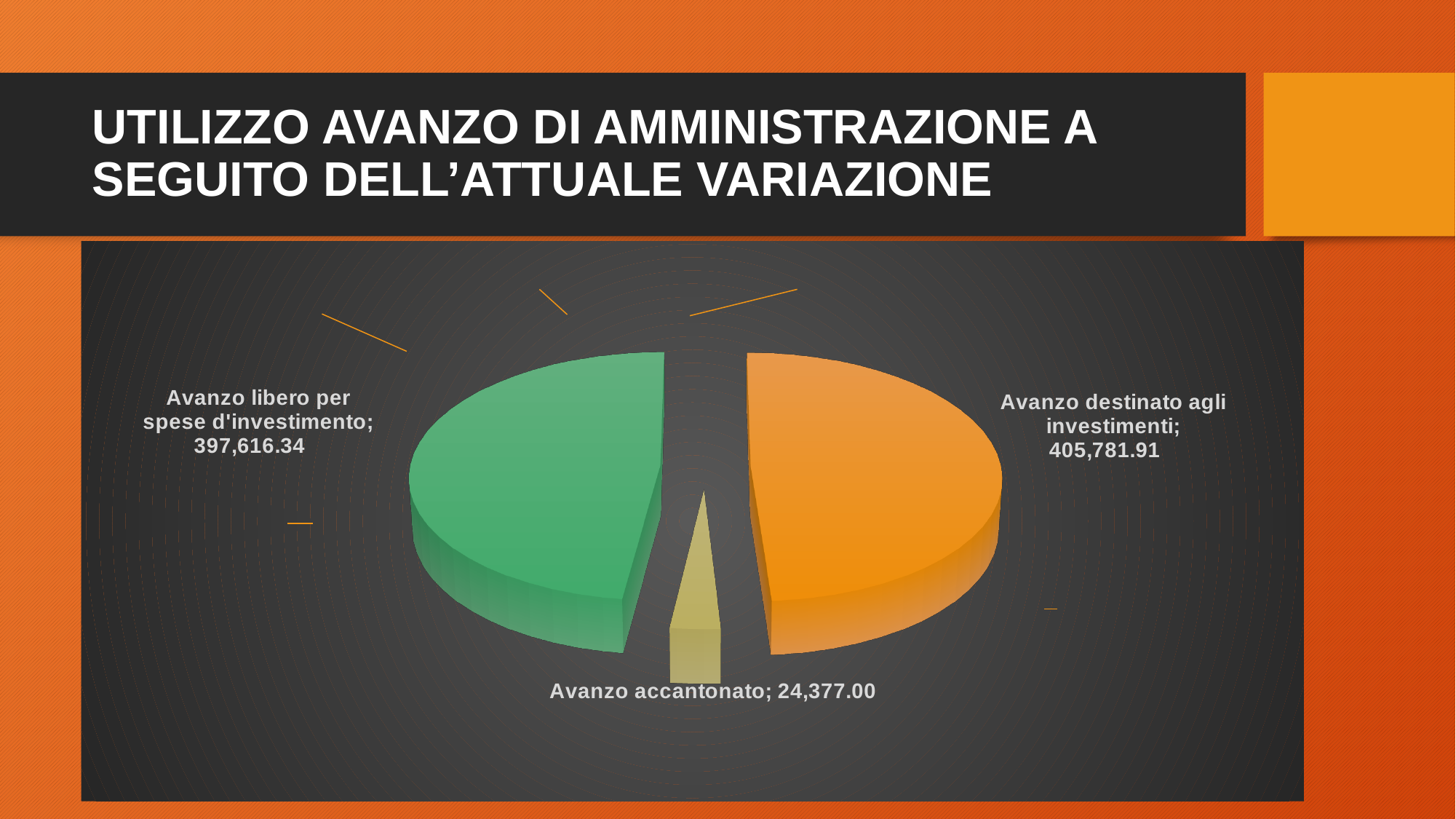
What is the difference between Avanzo destinato agli investimenti and Avanzo libero per spese d'investimento? 8,165.57 Which category has the smallest value in the pie chart? Avanzo accantonato What kind of chart is shown on the slide? Pie chart What is the value for Avanzo destinato agli investimenti? 405,781.91 What is the value for Avanzo accantonato? 24,377.00 What is the difference between Avanzo libero per spese d'investimento and Avanzo accantonato? 373,239.34 Which category has the largest value in the pie chart? Avanzo destinato agli investimenti What is the value for Avanzo libero per spese d'investimento? 397,616.34 Which is larger, Avanzo destinato agli investimenti or Avanzo libero per spese d'investimento? Avanzo destinato agli investimenti How many slices does the pie chart have? 3 What is the total of all three slices in the pie chart? 827,775.25 What colour is the Avanzo libero per spese d'investimento slice? Green